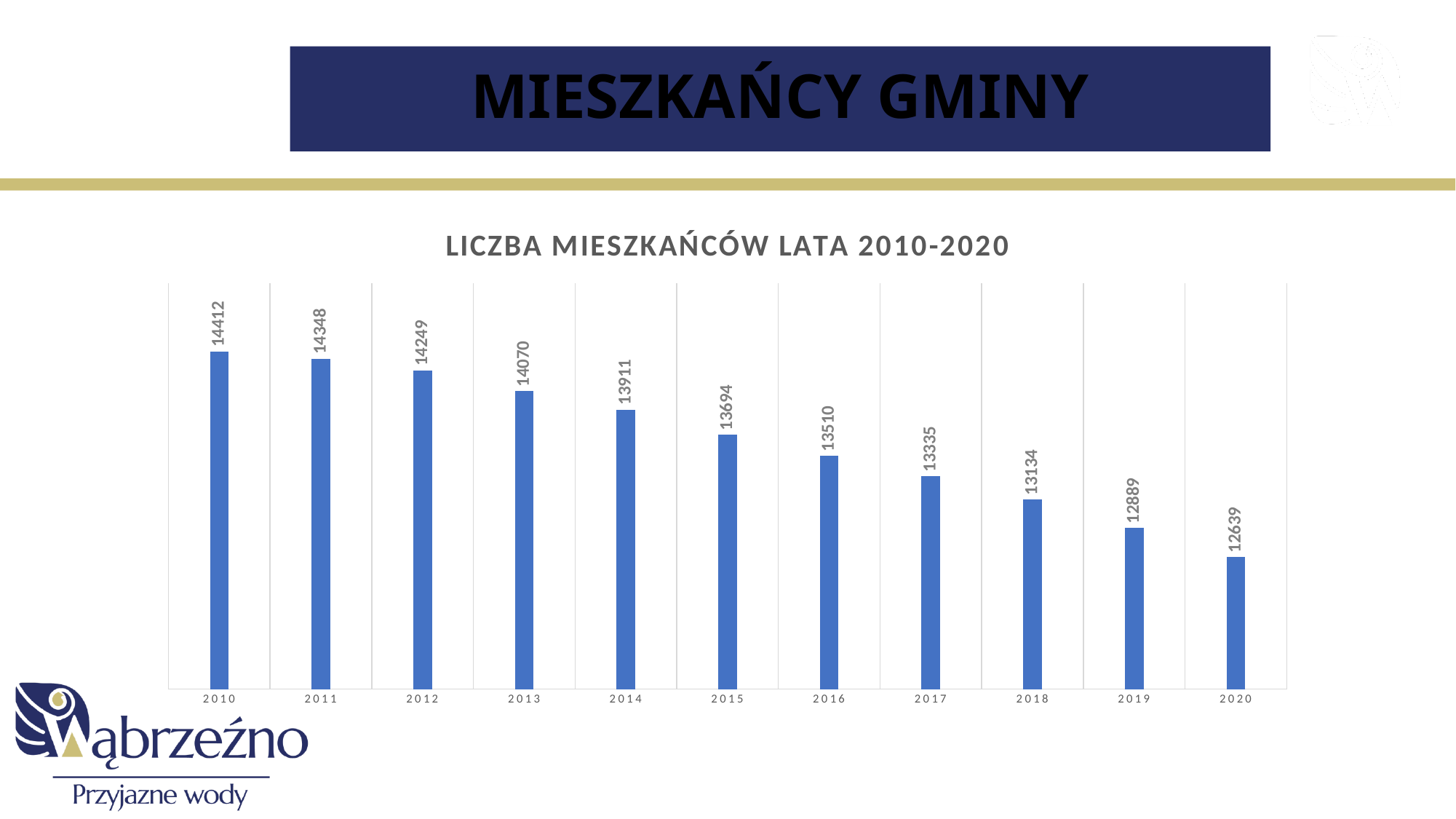
How many years are shown on the x axis? 11 What kind of chart is shown on the slide? bar chart Which is larger, the value for 2013 or the value for 2016? 2013 What is the title of the chart? LICZBA MIESZKAŃCÓW LATA 2010-2020 What is the difference between the values for 2010 and 2020? 1773 What is the difference between the values for 2018 and 2019? 245 Which year has the lowest number of residents? 2020 What is the number of residents shown for 2010? 14412 What value is shown for 2015? 13694 Which year has the highest number of residents? 2010 Do the values rise or fall from 2010 to 2020? fall What is the number of residents shown for 2020? 12639